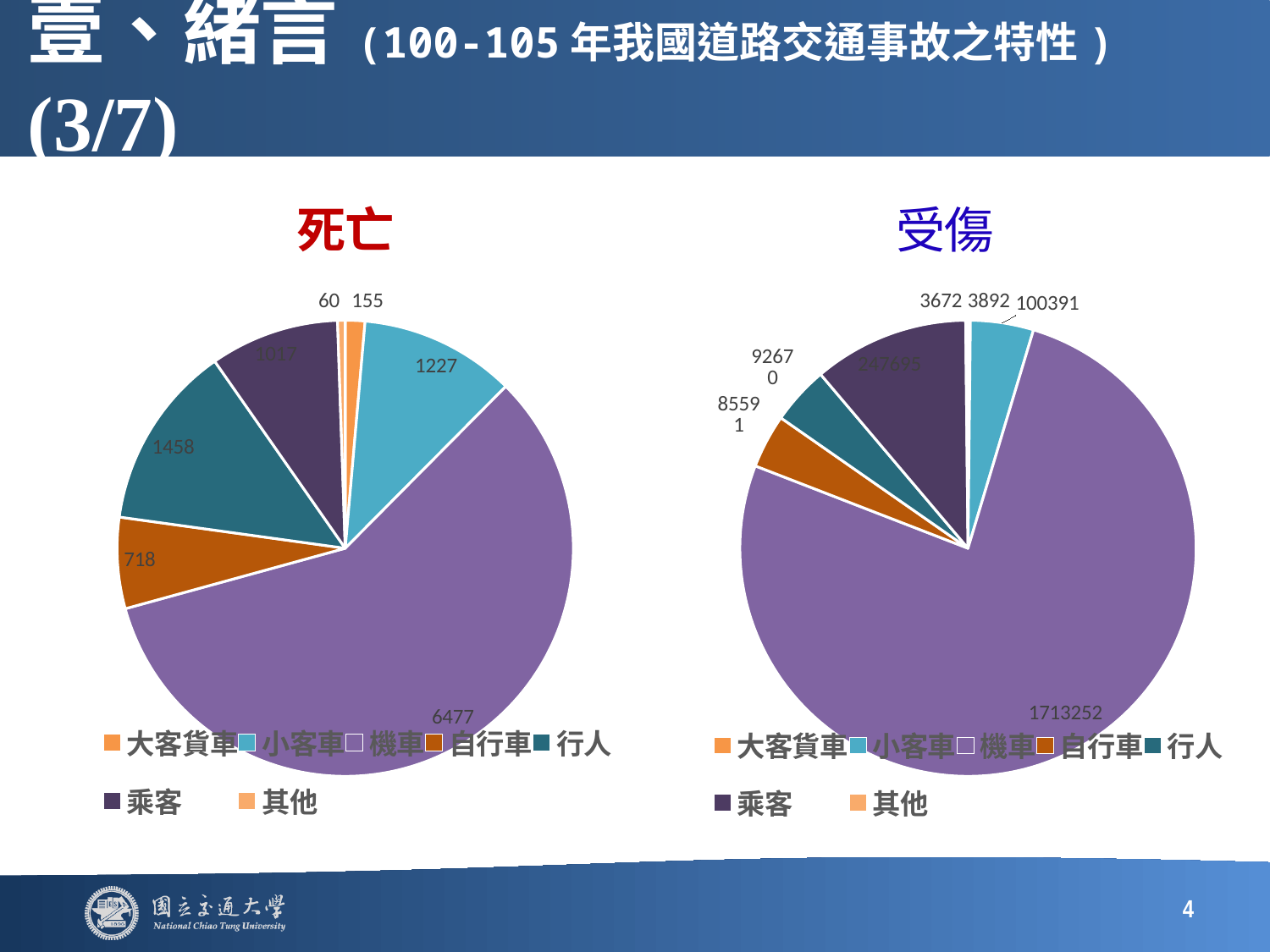
In the 死亡 chart, what is the value for 行人? 1458 In the 死亡 chart, what is the value for 自行車? 718 In the 受傷 chart, what is the value for 機車? 1713252 In the 死亡 chart, what is the difference between 行人 and 自行車? 740 In the 死亡 chart, what is the value for 小客車? 1227 In the 受傷 chart, what is the value for 乘客? 247695 In the 死亡 chart, which is larger, 行人 or 乘客? 行人 How many categories does the legend of the 受傷 chart list? 7 In the 死亡 chart, what is the value for 乘客? 1017 What kind of charts are shown on the slide? Pie charts In the 死亡 chart, what is the value for 機車? 6477 In the 死亡 chart, which category has the largest slice? 機車